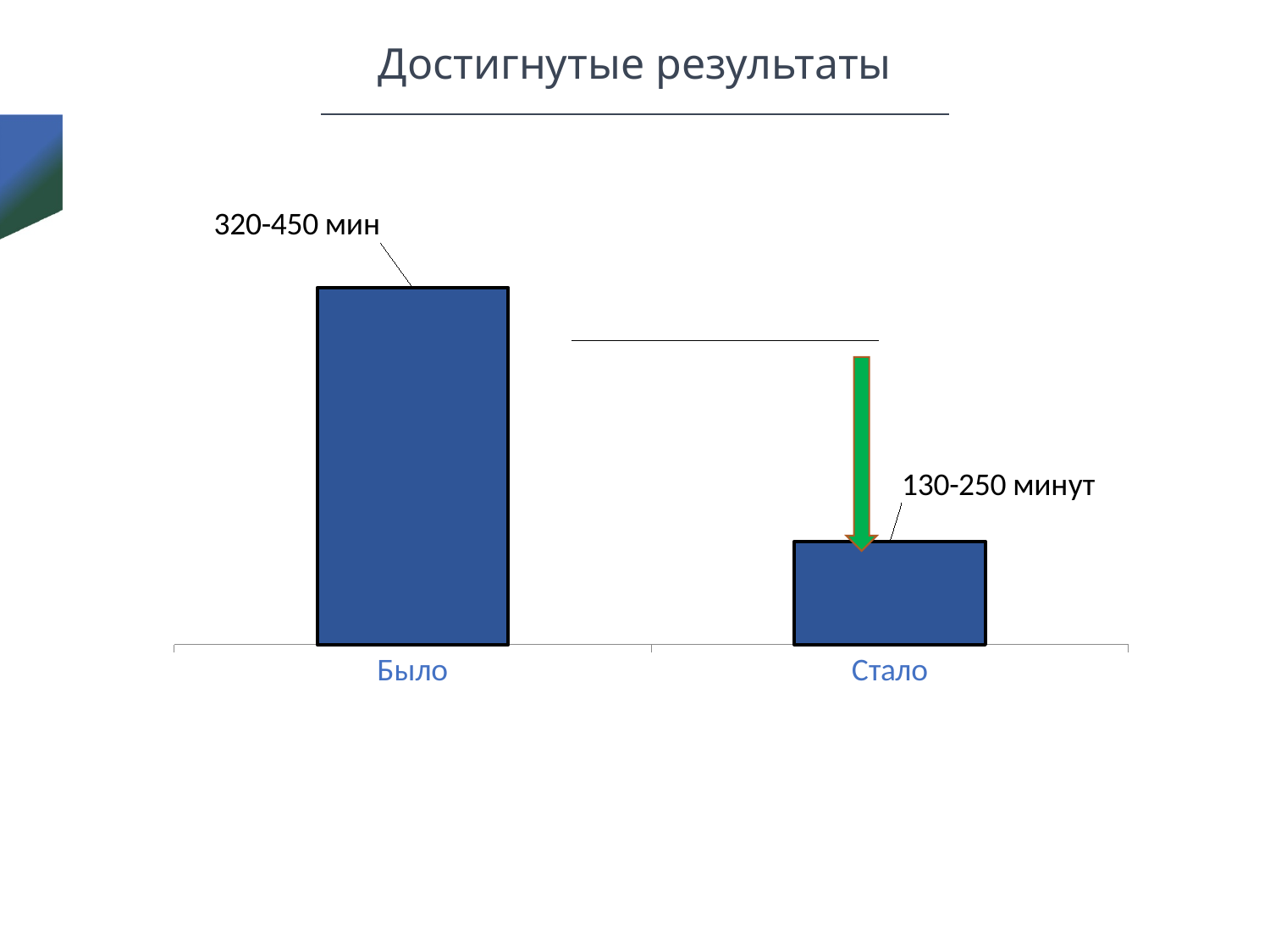
How many bars are shown in the chart? 2 What kind of chart is shown on the slide? bar chart Which category has the shorter bar? Стало Is the bar for Было taller or shorter than the bar for Стало? taller What is the data label on the bar for Было? 320-450 мин Which category has the taller bar? Было What colour is the arrow pointing down at the Стало bar? green Do the values rise or fall from Было to Стало? fall What is the data label on the bar for Стало? 130-250 минут What is the title of the slide? Достигнутые результаты